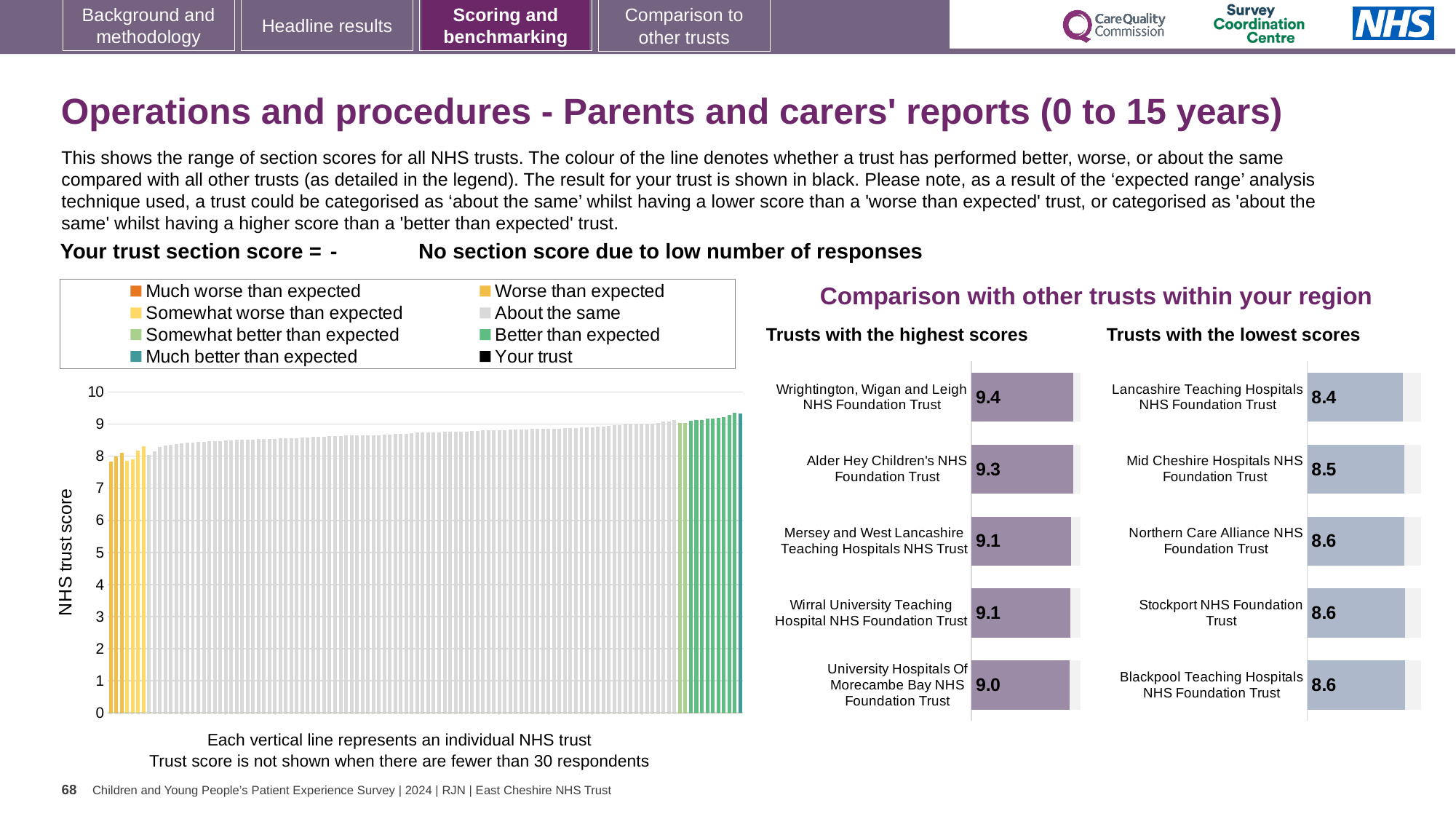
In the large chart on the left, do the NHS trust scores rise or fall from left to right along the x axis? Rise In the 'Trusts with the lowest scores' chart, which trust has the lowest score? Lancashire Teaching Hospitals NHS Foundation Trust Which is larger: the score for Alder Hey Children's NHS Foundation Trust in the highest scores chart or the score for Stockport NHS Foundation Trust in the lowest scores chart? Alder Hey Children's NHS Foundation Trust In the 'Trusts with the highest scores' chart, what is the score for University Hospitals Of Morecambe Bay NHS Foundation Trust? 9.0 In the 'Trusts with the highest scores' chart, which trust has the highest score? Wrightington, Wigan and Leigh NHS Foundation Trust In the 'Trusts with the highest scores' chart, what is the score for Wrightington, Wigan and Leigh NHS Foundation Trust? 9.4 In the 'Trusts with the lowest scores' chart, what is the score for Lancashire Teaching Hospitals NHS Foundation Trust? 8.4 In the 'Trusts with the lowest scores' chart, what is the difference between the scores of Mid Cheshire Hospitals NHS Foundation Trust and Lancashire Teaching Hospitals NHS Foundation Trust? 0.1 What kind of chart is the large chart on the left showing NHS trust scores? Bar chart How many trusts are listed in the 'Trusts with the lowest scores' chart? 5 How many entries does the legend of the large chart on the left list? 8 In the 'Trusts with the highest scores' chart, what is the difference between the scores of Wrightington, Wigan and Leigh NHS Foundation Trust and Alder Hey Children's NHS Foundation Trust? 0.1